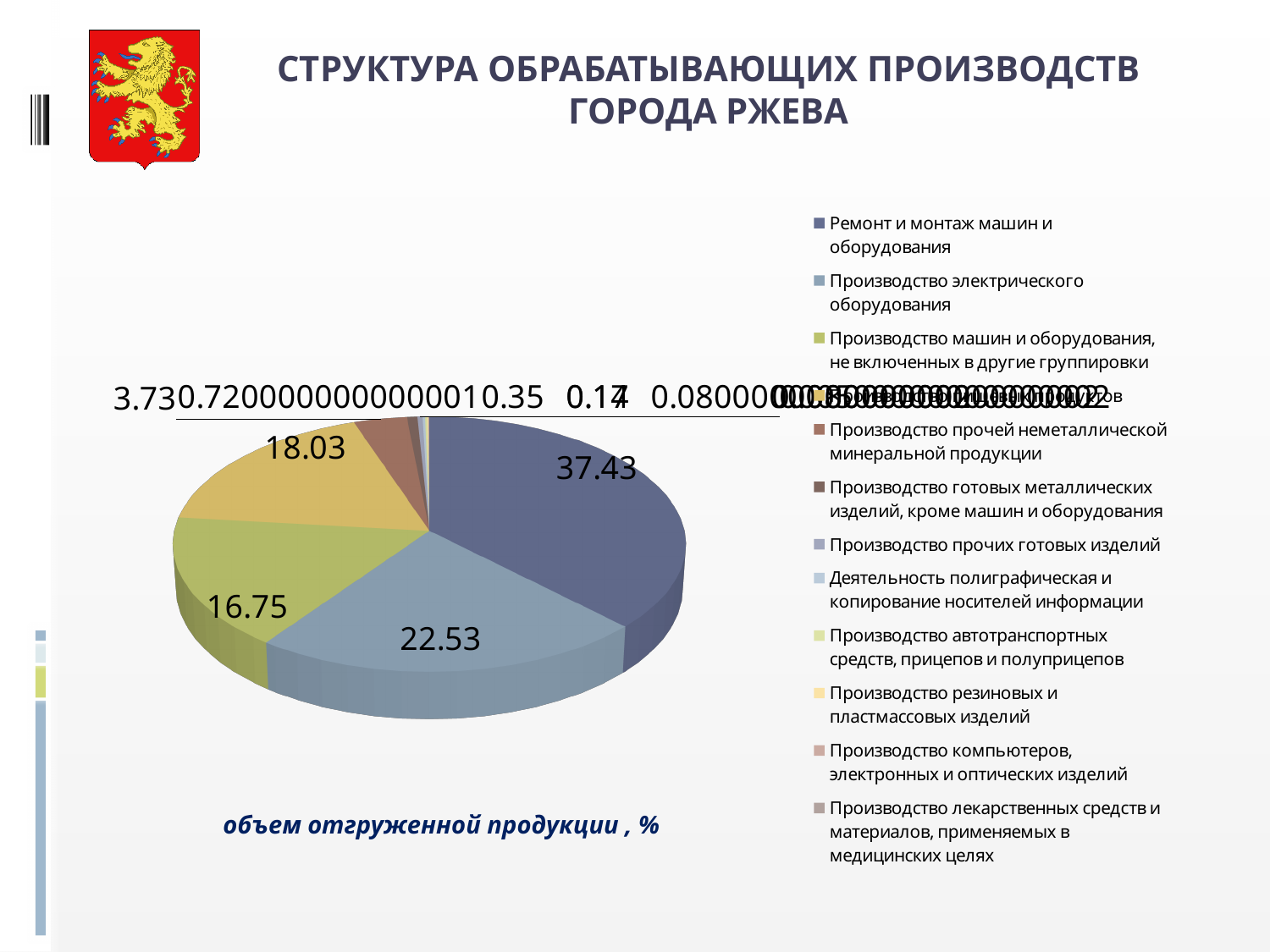
What kind of chart is shown on the slide? Pie chart Which is larger: the slice for Производство электрического оборудования or the slice for Производство машин и оборудования, не включенных в другие группировки? Производство электрического оборудования What is the difference between the value for Производство электрического оборудования and the value for Производство машин и оборудования, не включенных в другие группировки? 5.78 What is the value for Производство электрического оборудования? 22.53 What is the title shown below the pie chart? объем отгруженной продукции , % What is the value for Производство машин и оборудования, не включенных в другие группировки? 16.75 Which category has the largest slice of the pie? Ремонт и монтаж машин и оборудования How many categories does the legend list? 12 What is the value for Ремонт и монтаж машин и оборудования? 37.43 What colour is the slice for Ремонт и монтаж машин и оборудования? Dark blue What is the difference between the value for Ремонт и монтаж машин и оборудования and the value for Производство электрического оборудования? 14.90 What is the value for Производство прочей неметаллической минеральной продукции? 3.73